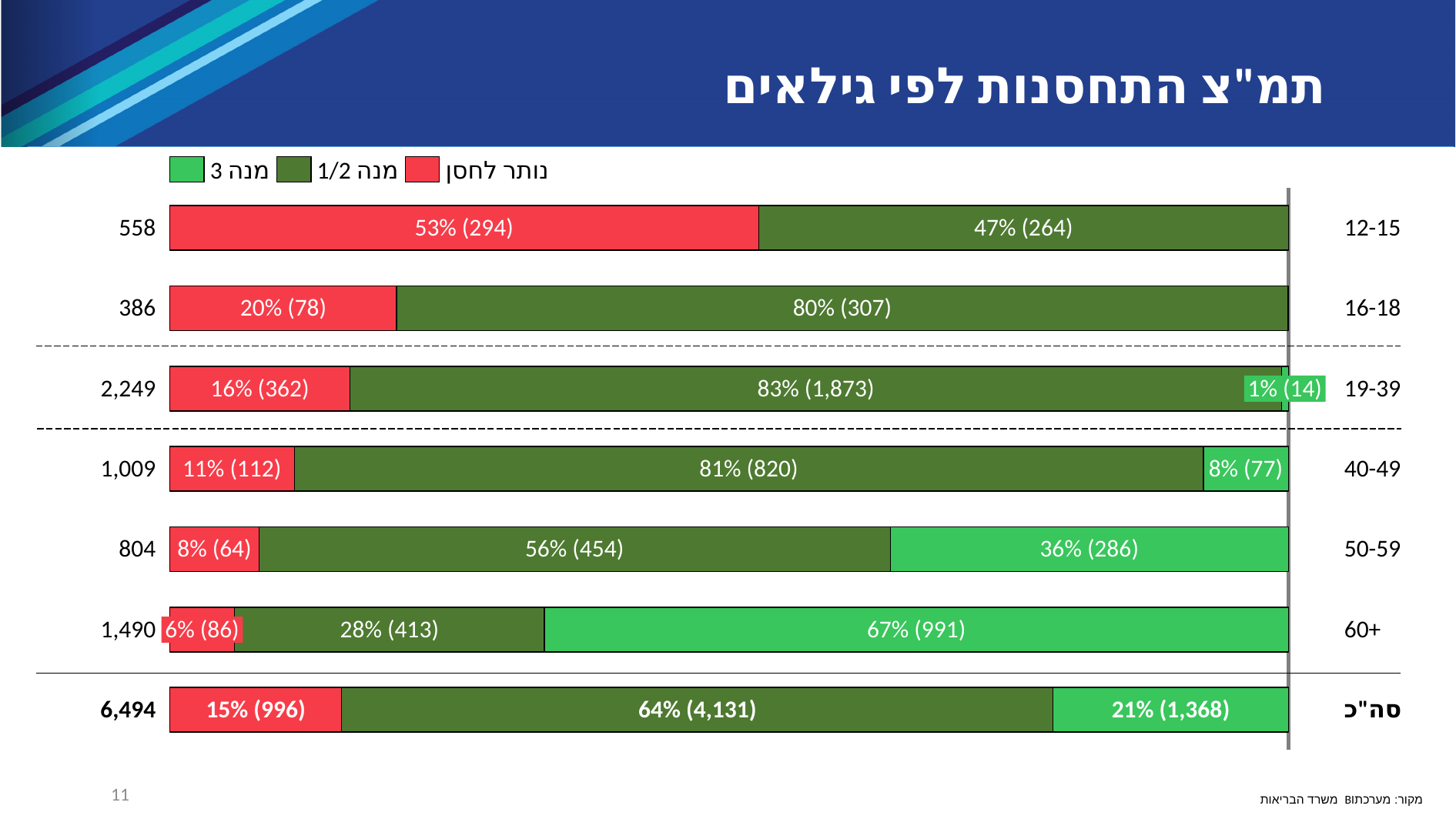
Which age group has the lowest "נותר לחסן" percentage? 60+ What type of chart is shown on the slide? Stacked bar chart How many age-group rows (excluding the סה"כ row) are shown in the chart? 6 What is the total shown for the 50-59 age group? 804 Which age group has the highest "נותר לחסן" percentage? 12-15 What is the value of the "מנה 3" segment for the 60+ age group? 67% (991) What is the total shown for the סה"כ row? 6,494 How many series does the legend list? 3 What is the difference in count between the "מנה 1/2" segment and the "נותר לחסן" segment for the 16-18 age group? 229 What is the value of the "נותר לחסן" segment for the 12-15 age group? 53% (294) What is the value of the "מנה 1/2" segment for the 19-39 age group? 83% (1,873) Which is larger: the "מנה 3" count for 50-59 or for 40-49? 50-59